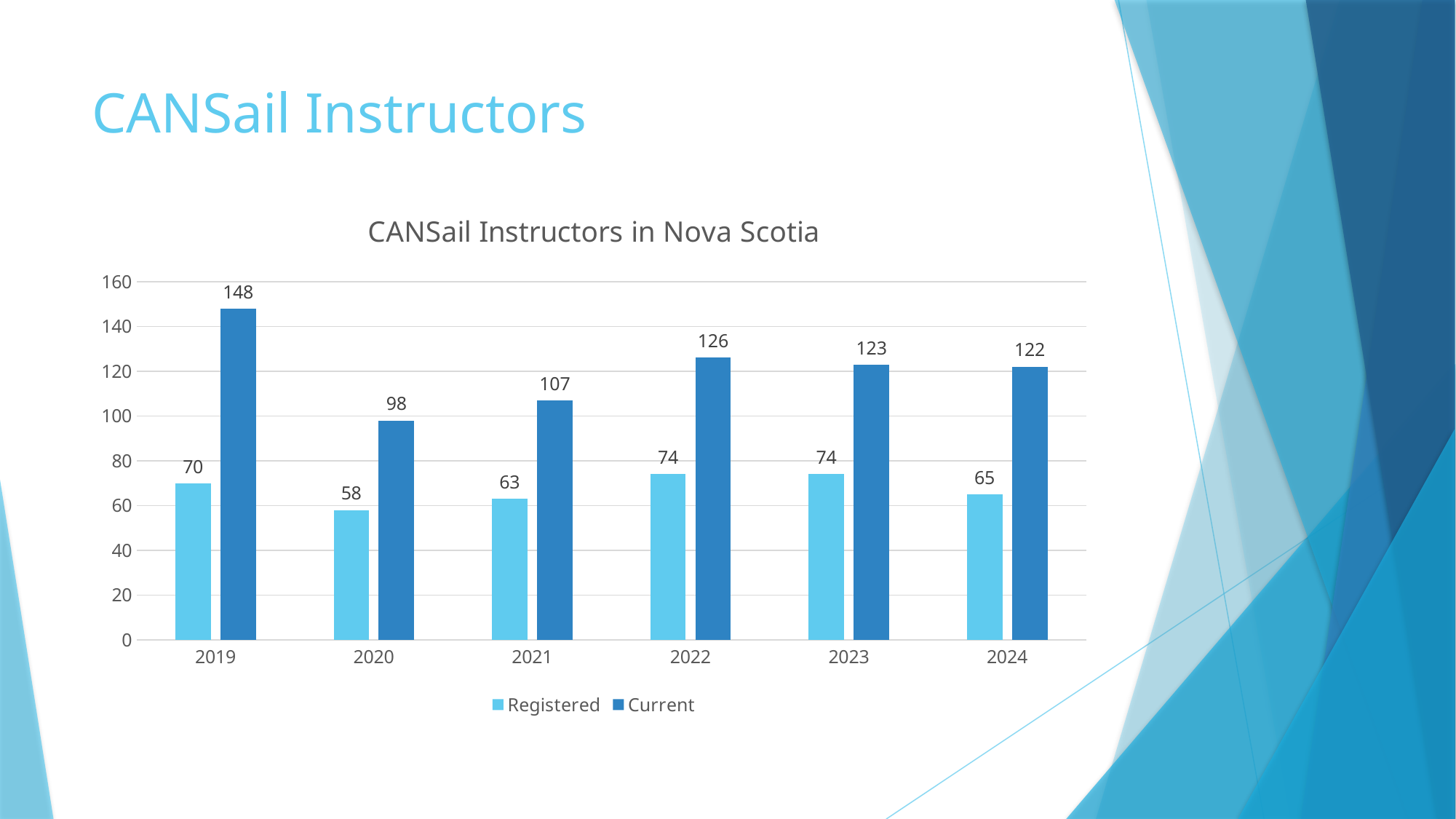
What is the Registered value for 2020? 58 What is the Current value for 2019? 148 What is the title of the chart? CANSail Instructors in Nova Scotia Which year has the lowest Registered value? 2020 What is the difference between the Current and Registered values in 2021? 44 What kind of chart is shown? bar chart How many series does the legend list? 2 How many years are shown on the x axis? 6 Which is larger, the Current value for 2020 or the Current value for 2024? 2024 What is the Current value for 2022? 126 Which year has the highest Current value? 2019 Which series is shown in the darker blue colour? Current